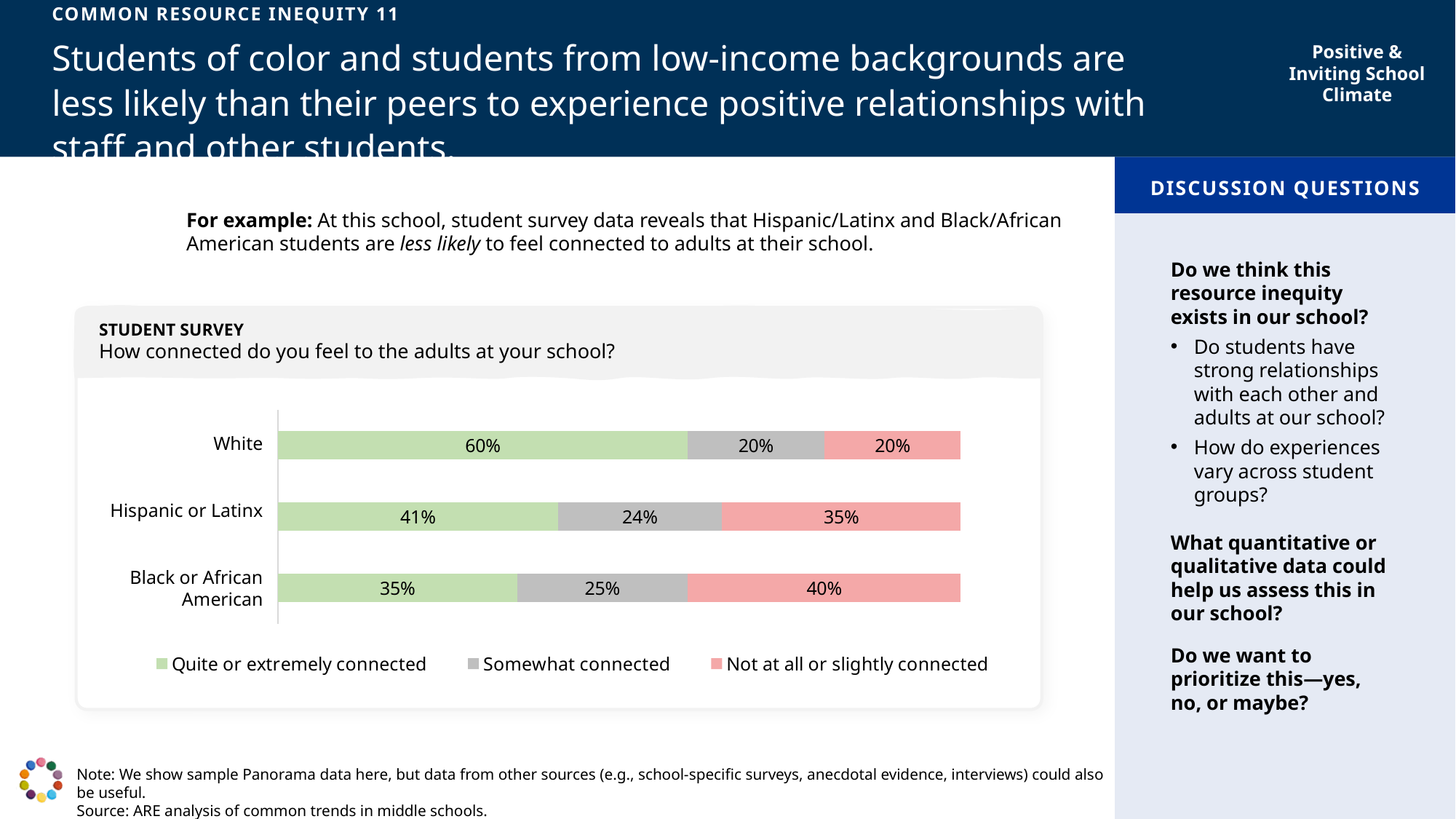
Which group has a larger share of students who feel not at all or slightly connected: Hispanic or Latinx or Black or African American? Black or African American What percentage of Black or African American students reported feeling somewhat connected? 25% How many student groups are shown in the chart? 3 What percentage of White students reported feeling quite or extremely connected to adults at their school? 60% What survey question does the chart display responses to? How connected do you feel to the adults at your school? How many response categories does the legend list? 3 What percentage of Hispanic or Latinx students reported feeling not at all or slightly connected? 35% Which student group has the highest share of students who feel quite or extremely connected? White Which student group has the lowest share of students who feel quite or extremely connected? Black or African American What type of chart is used to show the student survey results? Stacked bar chart What is the difference between the share of White students and Black or African American students who feel quite or extremely connected? 25% What is the total of the three segments in the Hispanic or Latinx bar? 100%